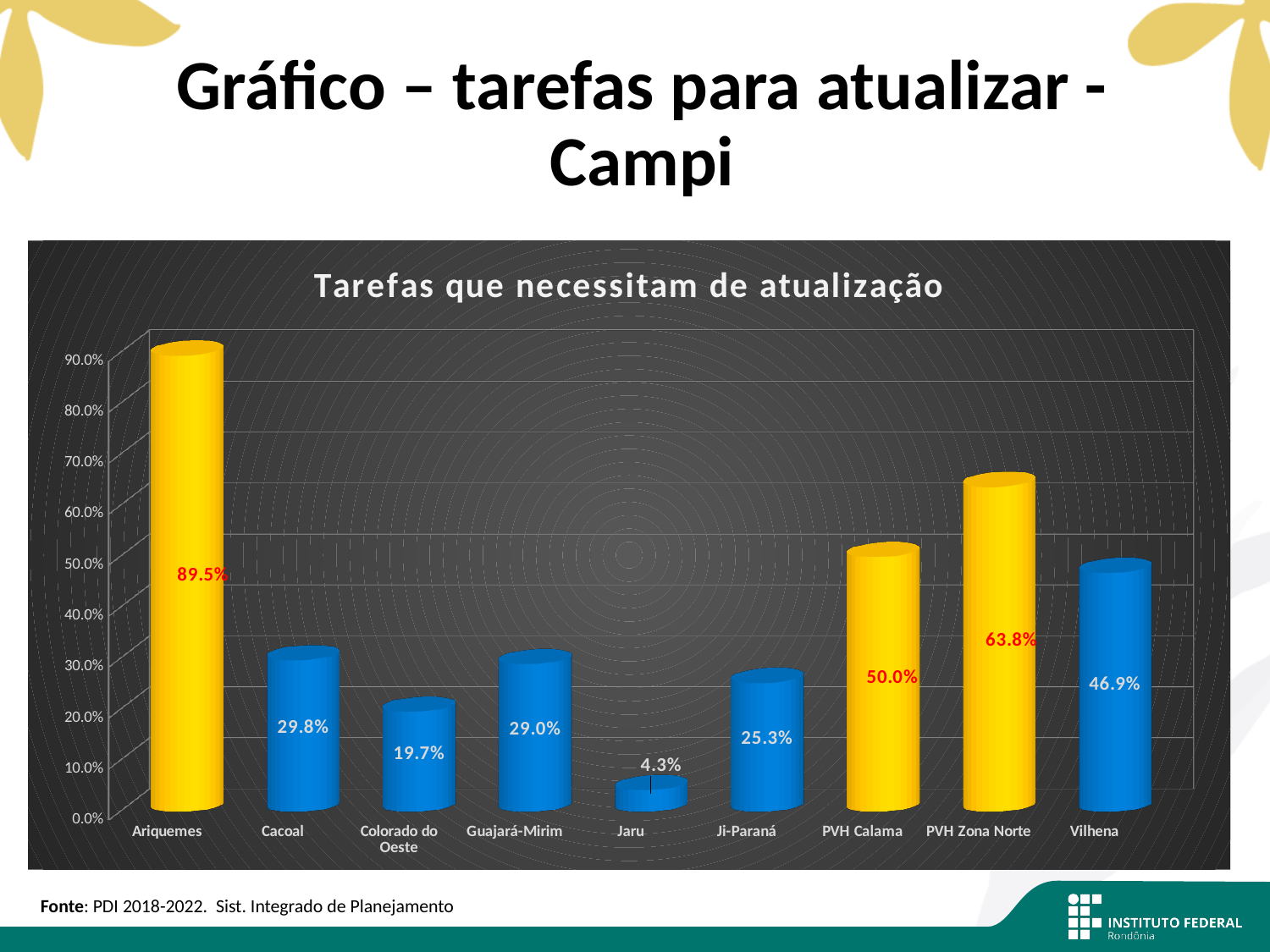
What is the value for PVH Zona Norte? 63.8% What kind of chart is shown on the slide? Bar chart What is the difference between the values for PVH Zona Norte and PVH Calama? 13.8 percentage points What is the value for Colorado do Oeste? 19.7% Is the value for Vilhena greater or less than 50.0%? less What is the title of the chart? Tarefas que necessitam de atualização What is the value for Jaru? 4.3% Which is larger, the value for Vilhena or the value for Ji-Paraná? Vilhena Which campus has the lowest value? Jaru How many campi are shown on the x axis? 9 What is the value for Ariquemes? 89.5% Which campus has the highest value? Ariquemes